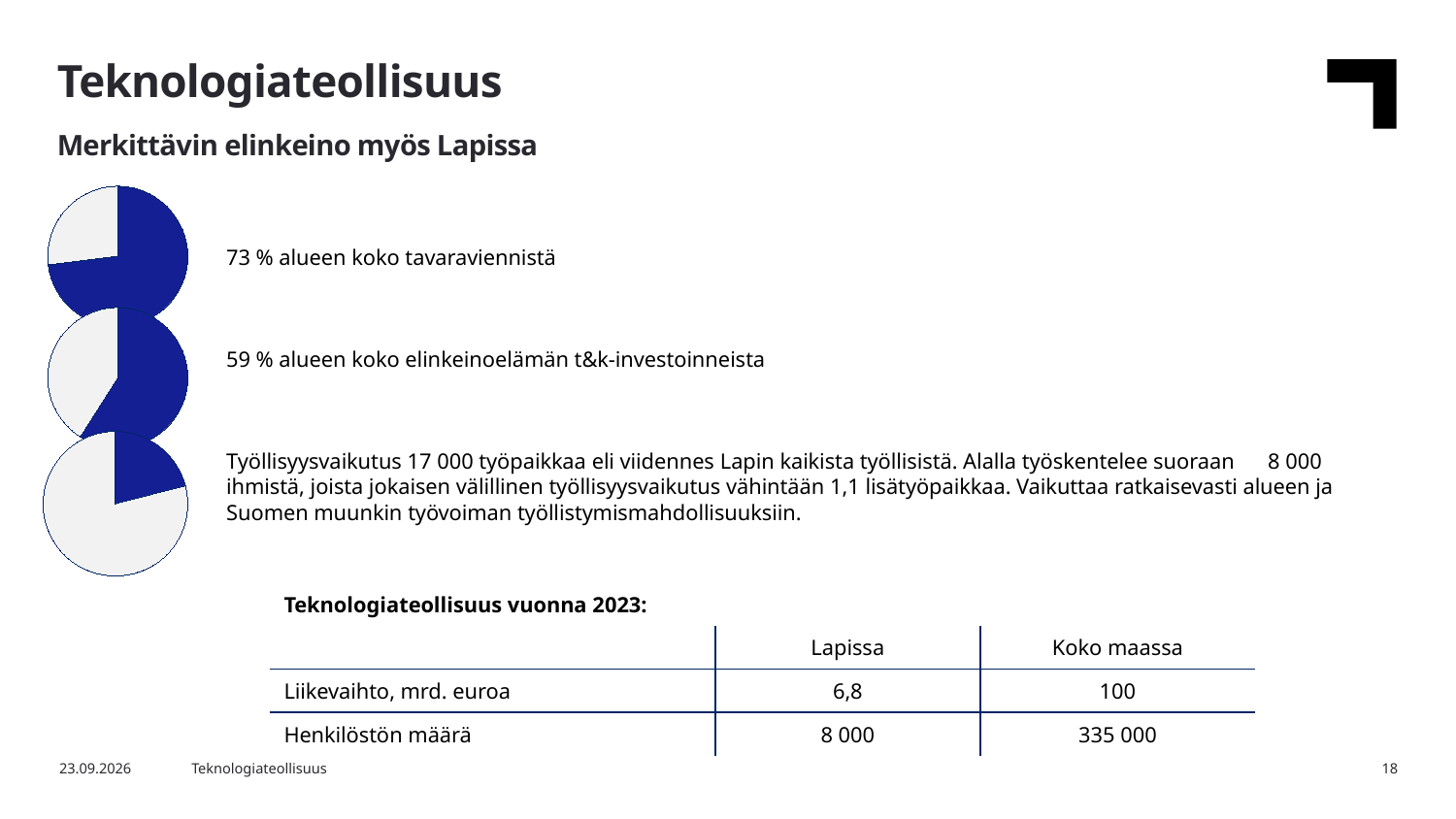
By how many percentage points does the share in the top pie chart (73 %) exceed the share in the middle pie chart (59 %)? 14 percentage points Is the highlighted share larger in the top pie chart (tavaravienti) or in the middle pie chart (t&k-investoinnit)? Top pie chart (tavaravienti) Is the highlighted slice in the bottom pie chart greater or less than half of the pie? less Which pie chart has the largest highlighted slice: the top, middle or bottom one? Top Which pie chart has the smallest highlighted slice: the top, middle or bottom one? Bottom What does the top pie chart illustrate, according to the text next to it? 73 % alueen koko tavaraviennistä In the middle pie chart, what share of the region's business R&D investments (t&k-investoinnit) does the highlighted slice represent? 59 % How many pie charts are on the slide? 3 In the top pie chart, what share of the region's total goods exports (tavaravienti) does the highlighted slice represent? 73 % What colour is the highlighted slice in the pie charts? Dark blue Is the highlighted slice in the top pie chart greater or less than half of the pie? greater What kind of charts are shown on the left side of the slide? Pie charts